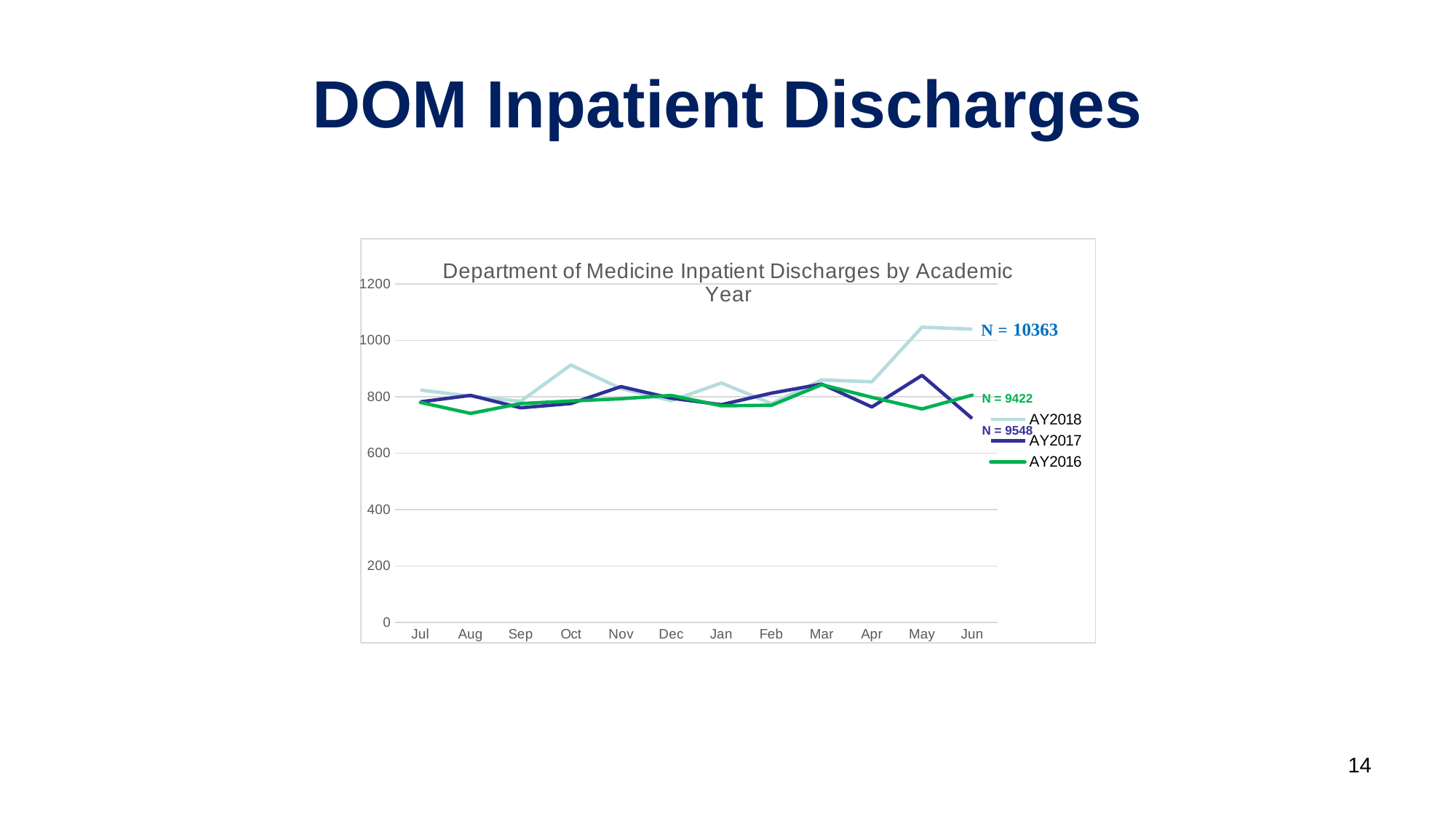
Does the AY2018 line rise or fall from April to May? rise What is the N value annotated for AY2016? N = 9422 What is the difference between the annotated N totals for AY2018 and AY2017? 815 What kind of chart is shown on the slide? line chart Which academic year has the highest annotated N total? AY2018 Is the AY2018 value for May greater or less than 1000? greater How many months are plotted along the x axis? 12 In October, which series has the larger value, AY2018 or AY2017? AY2018 Which academic year has the lowest annotated N total? AY2016 What is the title of the chart? Department of Medicine Inpatient Discharges by Academic Year How many series does the legend list? 3 What is the N value annotated for AY2018? N = 10363